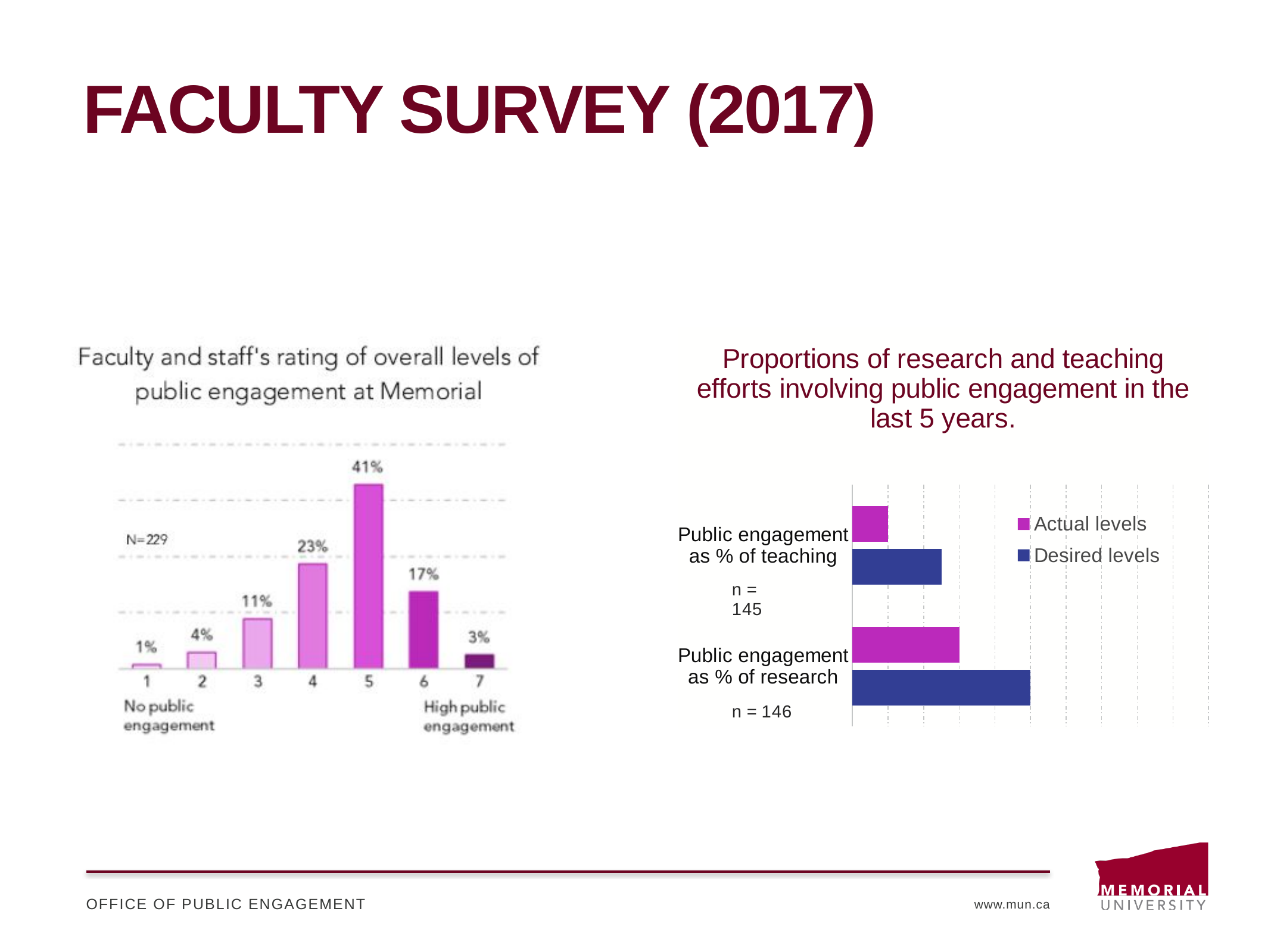
In the left chart, which rating received the highest percentage of respondents? 5 In the left chart, what is the sample size (N) shown? N=229 In the left chart, what percentage of respondents gave a rating of 7? 3% In the left chart, which rating received the lowest percentage of respondents? 1 In the left chart, which has a higher percentage: rating 4 or rating 6? Rating 4 What kind of chart is the right chart on the slide? Bar chart In the left chart, what is the difference in percentage points between rating 5 and rating 4? 18 In the left chart, 'Faculty and staff's rating of overall levels of public engagement at Memorial', what percentage of respondents gave a rating of 5? 41% In the left chart, what percentage of respondents gave a rating of 3? 11% In the right chart, for 'Public engagement as % of research', which is larger: Actual levels or Desired levels? Desired levels How many rating categories are shown on the x axis of the left chart? 7 In the right chart, 'Proportions of research and teaching efforts involving public engagement in the last 5 years', how many series does the legend list? 2